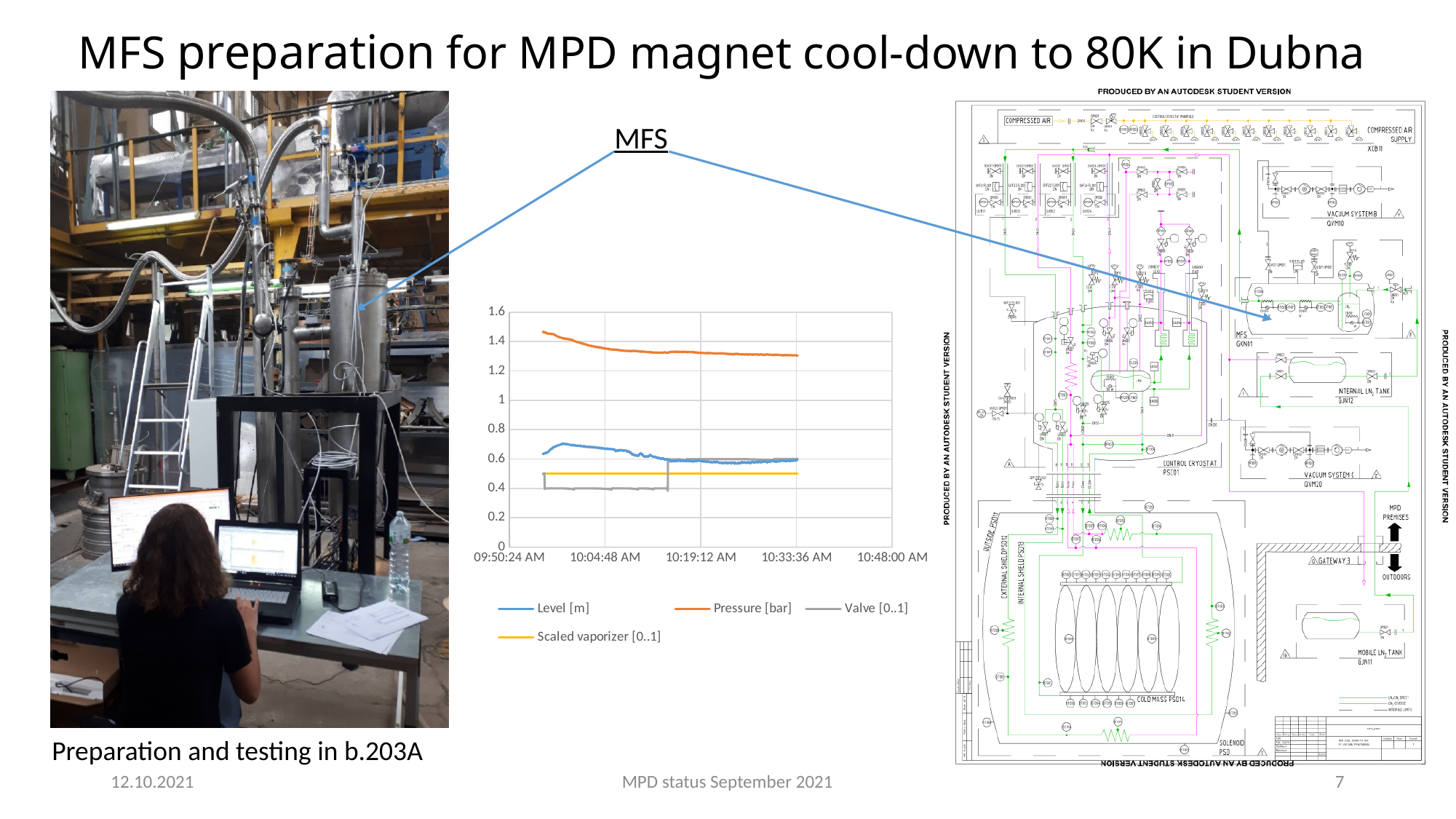
Is the Pressure [bar] value at the start of the chart greater or less than 1.4? greater Is the value of the Level [m] series greater or less than 1 throughout the chart? less What kind of chart is shown in the middle of the slide? line chart Which series has higher values, Pressure [bar] or Level [m]? Pressure [bar] Which series in the chart is plotted in orange? Pressure [bar] Is the value of the Scaled vaporizer [0..1] series greater or less than 0.4? greater Which series in the chart is plotted in yellow? Scaled vaporizer [0..1] Which series has the highest values in the chart? Pressure [bar] Does the Pressure [bar] series rise or fall over the time shown on the x axis? fall How many series does the legend of the chart list? 4 How many time labels are shown on the x axis of the chart? 5